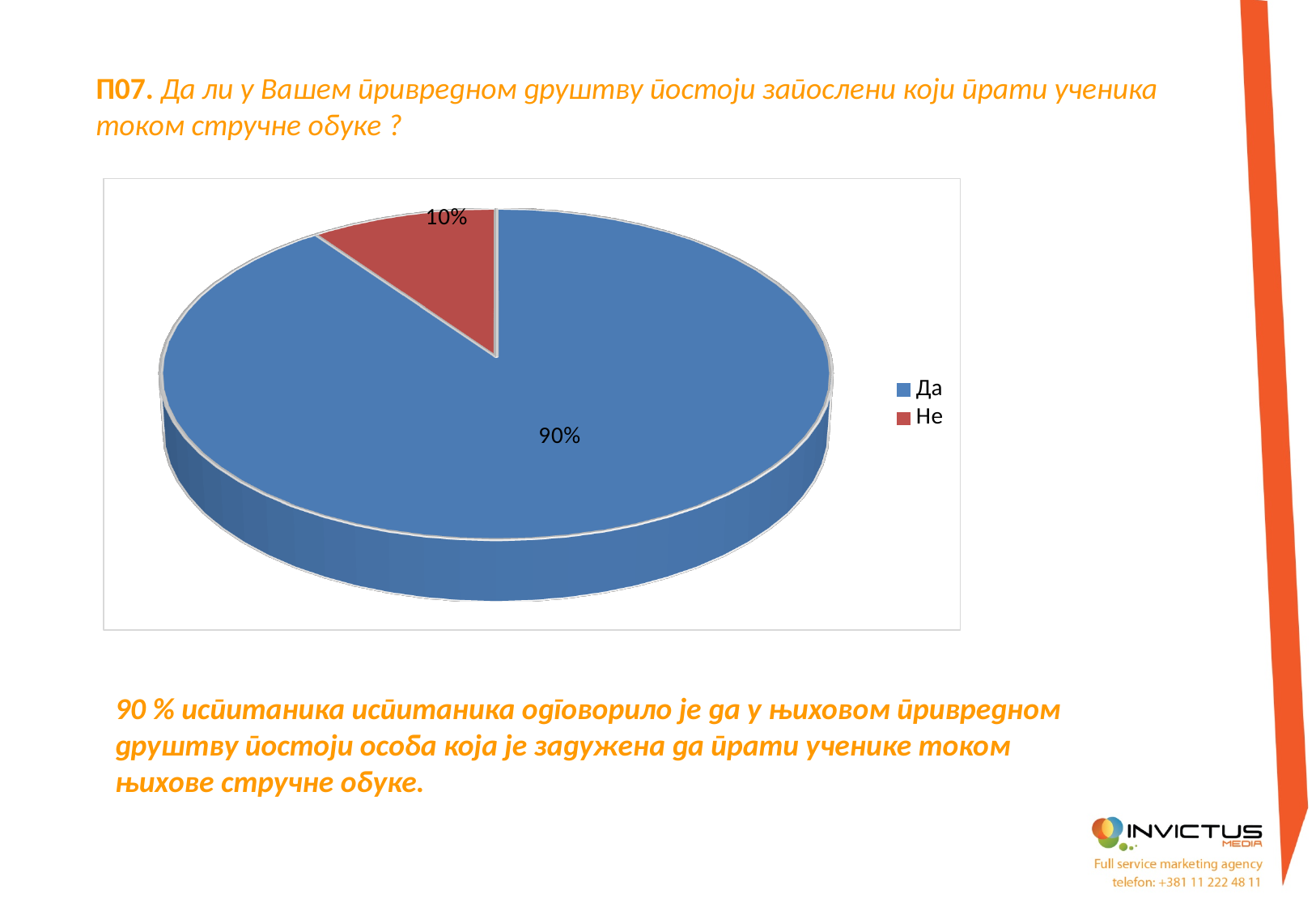
What share of the pie does the "Да" slice represent? 90% What kind of chart is shown on the slide? pie chart What colour is the "Да" slice in the pie chart? blue What colour is the "Не" slice in the pie chart? red How many slices does the pie chart have? 2 Which category has the smallest slice of the pie? Не Which slice is larger, "Да" or "Не"? Да How many entries does the legend list? 2 What share of the pie does the "Не" slice represent? 10% What is the difference in percentage points between the "Да" and "Не" slices? 80 Which category has the largest slice of the pie? Да